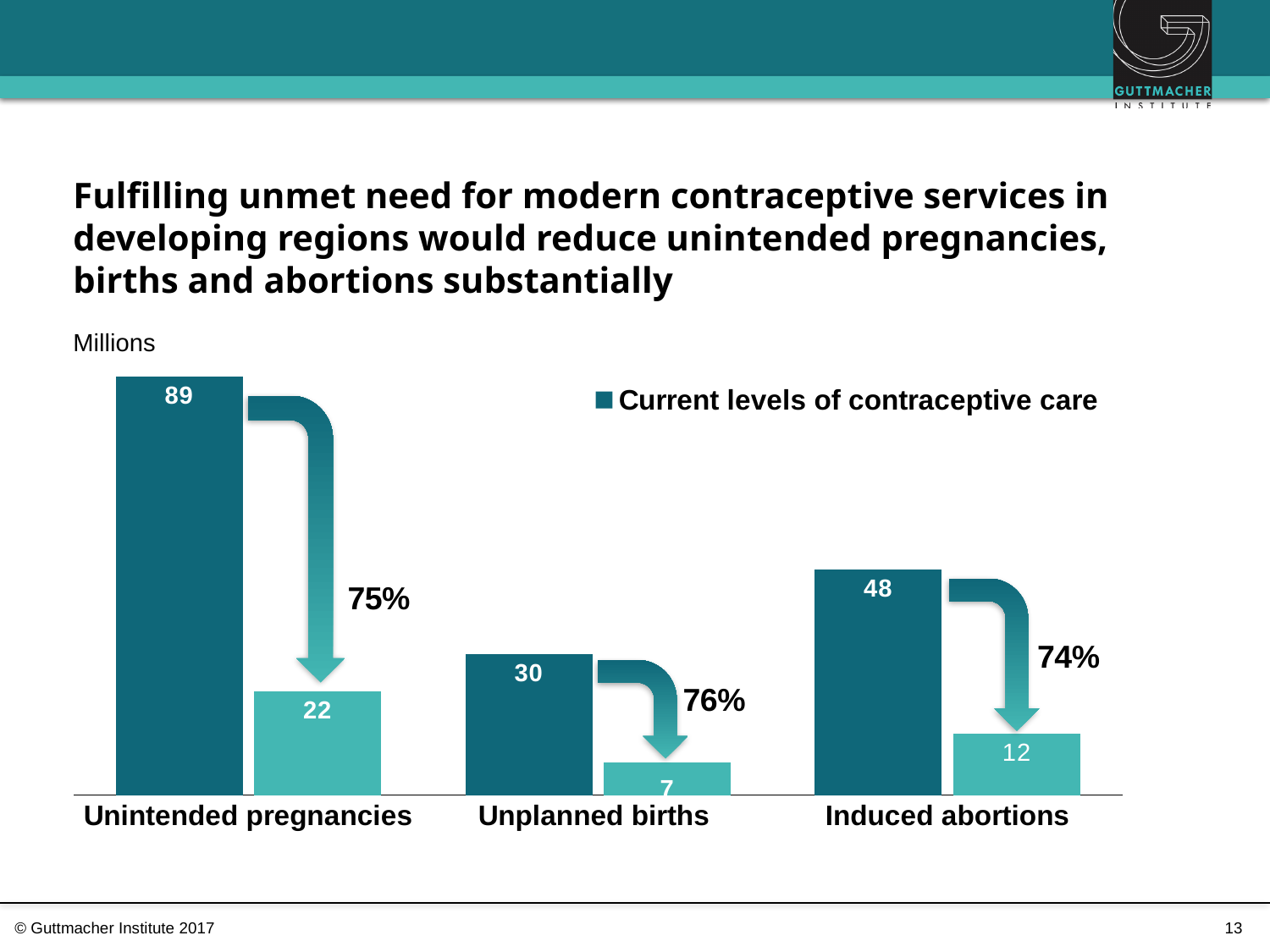
How many categories are shown on the x axis? 3 What is the value of the lighter teal bar for Induced abortions? 12 What is the difference between the two bars for Induced abortions? 36 Which category has the highest 'Current levels of contraceptive care' value? Unintended pregnancies What percentage reduction is shown by the arrow for Unplanned births? 76% Which is larger: the 'Current levels of contraceptive care' value for Unplanned births or for Induced abortions? Induced abortions What kind of chart is shown on the slide? Bar chart What unit label appears above the chart? Millions What is the value of the 'Current levels of contraceptive care' bar for Unplanned births? 30 What is the value of the 'Current levels of contraceptive care' bar for Unintended pregnancies? 89 What is the value of the lighter teal bar for Unintended pregnancies? 22 Which category has the lowest lighter teal bar value? Unplanned births